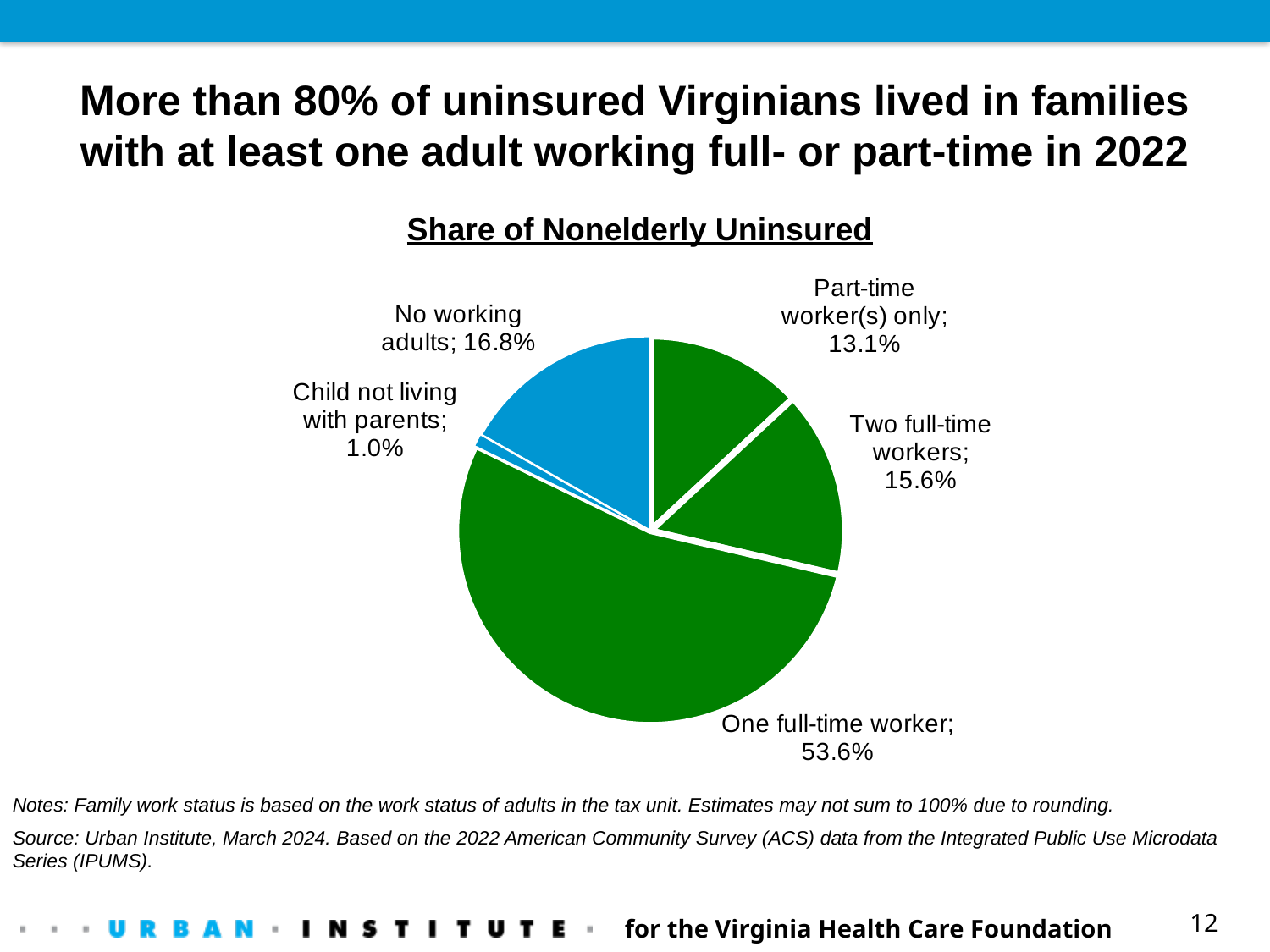
What share of the nonelderly uninsured lived in families with one full-time worker? 53.6% What share of the nonelderly uninsured lived in families with part-time worker(s) only? 13.1% What share of the nonelderly uninsured lived in families with no working adults? 16.8% Which category has the smallest share of the pie? Child not living with parents Which category has the largest share of the pie? One full-time worker What is the title of the pie chart? Share of Nonelderly Uninsured What is the difference in percentage points between the 'No working adults' share and the 'Two full-time workers' share? 1.2 What share of the nonelderly uninsured were children not living with parents? 1.0% Which is larger: the share for 'Two full-time workers' or the share for 'Part-time worker(s) only'? Two full-time workers How many slices does the pie chart have? 5 What is the combined share of 'One full-time worker' and 'Two full-time workers'? 69.2% What kind of chart is shown on the slide? pie chart